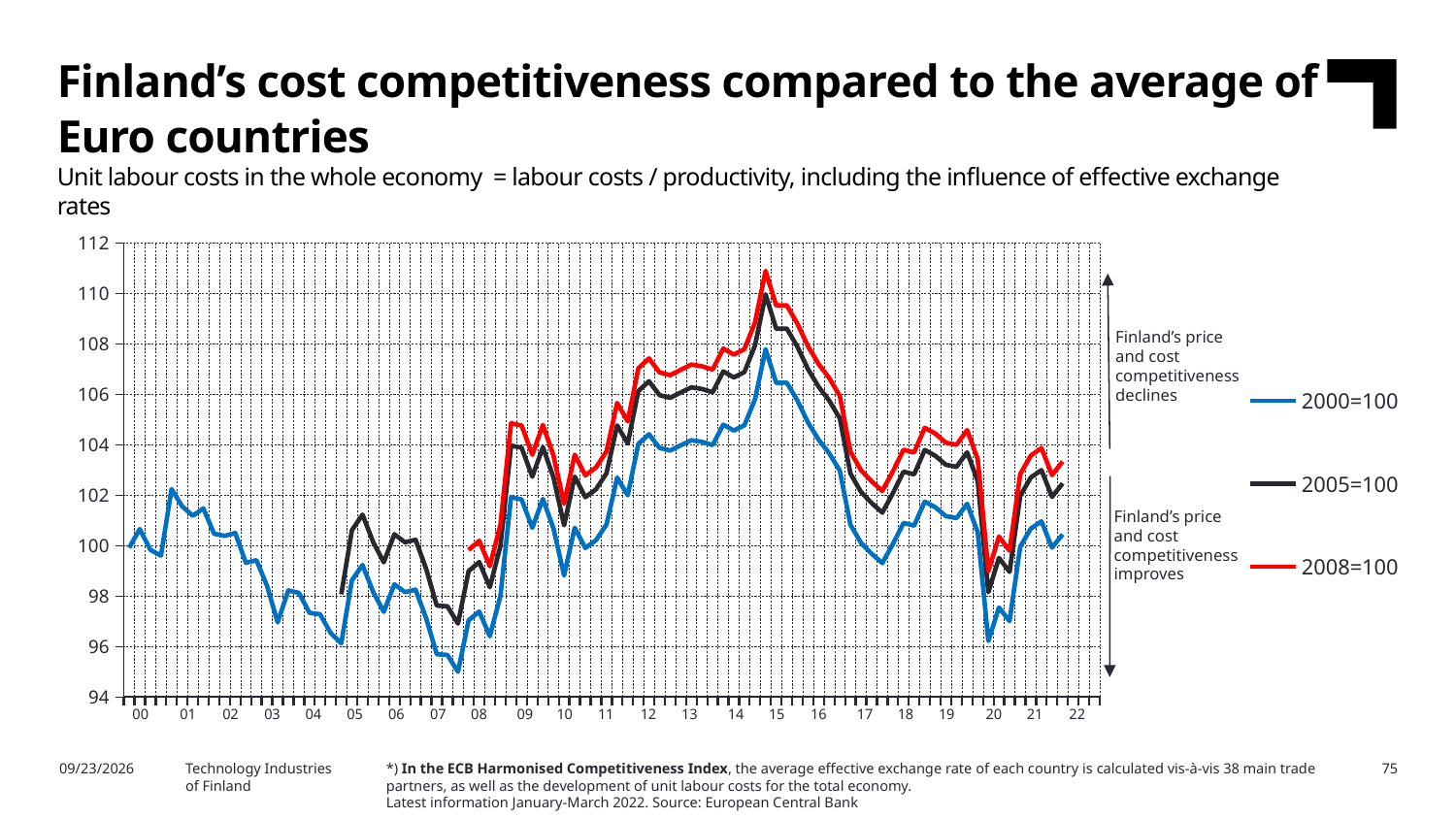
Is the value of the 2000=100 series at its dip in 2020 greater or less than 98? less Which series is drawn in blue? 2000=100 How many series does the legend list? 3 What kind of chart is shown on the slide? line chart Which series is drawn in red? 2008=100 Is the peak value of the 2008=100 series around 2015 greater or less than 108? greater Do the series rise or fall between 2015 and 2017? fall Which series has the lowest values across the period from 2008 onwards? 2000=100 Is the lowest value of the 2000=100 series around 2007 greater or less than 98? less How many year labels are shown on the x axis? 23 At the 2015 peak, which series has the higher value, 2008=100 or 2000=100? 2008=100